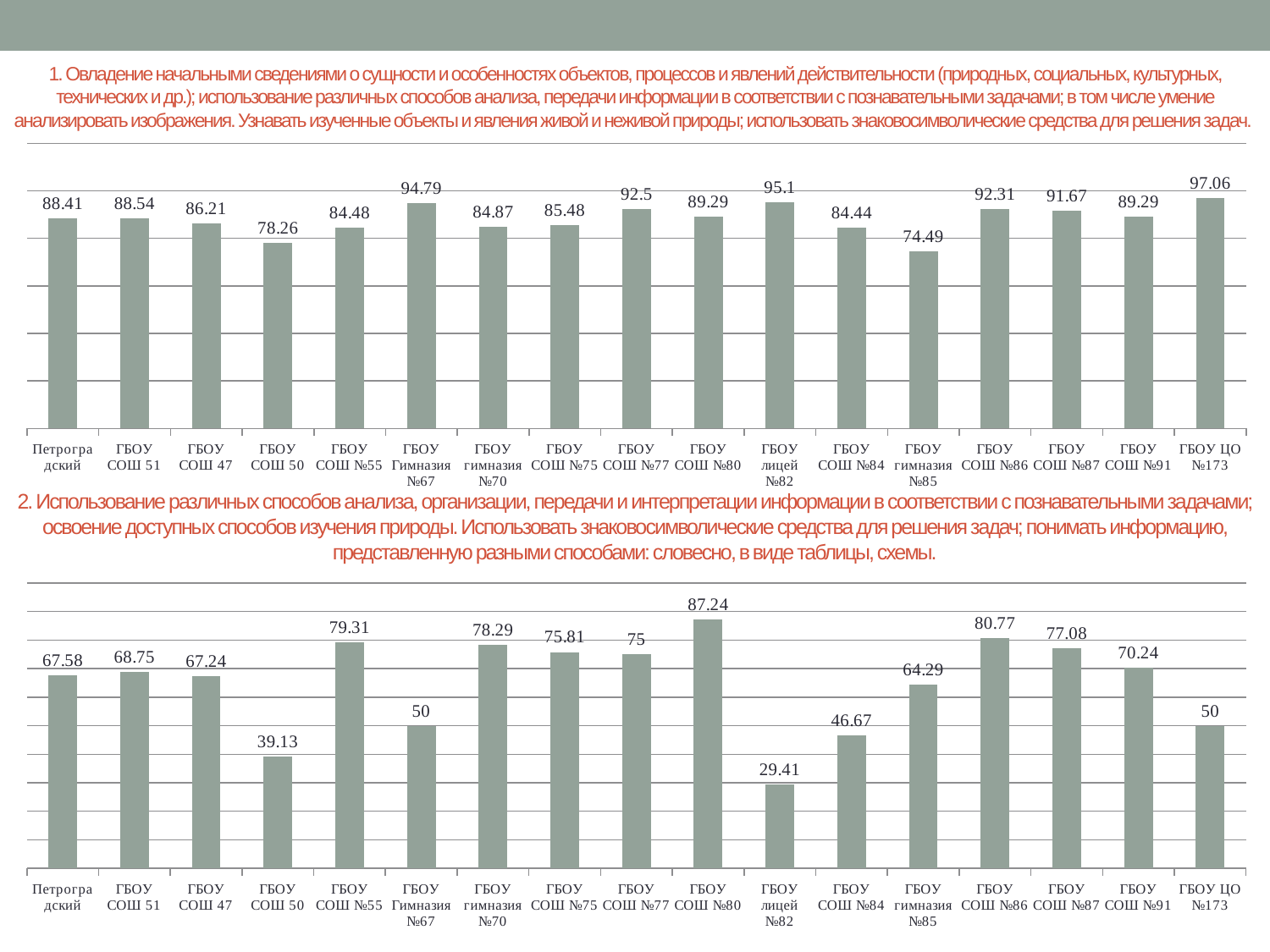
How many categories are shown in the bottom chart? 17 In the bottom chart, which category has the highest value? ГБОУ СОШ №80 In the bottom chart, which category has the lowest value? ГБОУ лицей №82 In the bottom chart, what is the value for ГБОУ лицей №82? 29.41 In the top chart, which category has the lowest value? ГБОУ гимназия №85 In the bottom chart, what is the value for ГБОУ СОШ №84? 46.67 In the top chart, which is larger: the value for ГБОУ Гимназия №67 or the value for ГБОУ СОШ №77? ГБОУ Гимназия №67 In the top chart, which category has the highest value? ГБОУ ЦО №173 In the top chart, what is the value for ГБОУ ЦО №173? 97.06 What kind of chart is the top chart? bar chart In the top chart, what is the value for ГБОУ СОШ 50? 78.26 In the bottom chart, what is the difference between the values for ГБОУ СОШ №80 and ГБОУ лицей №82? 57.83